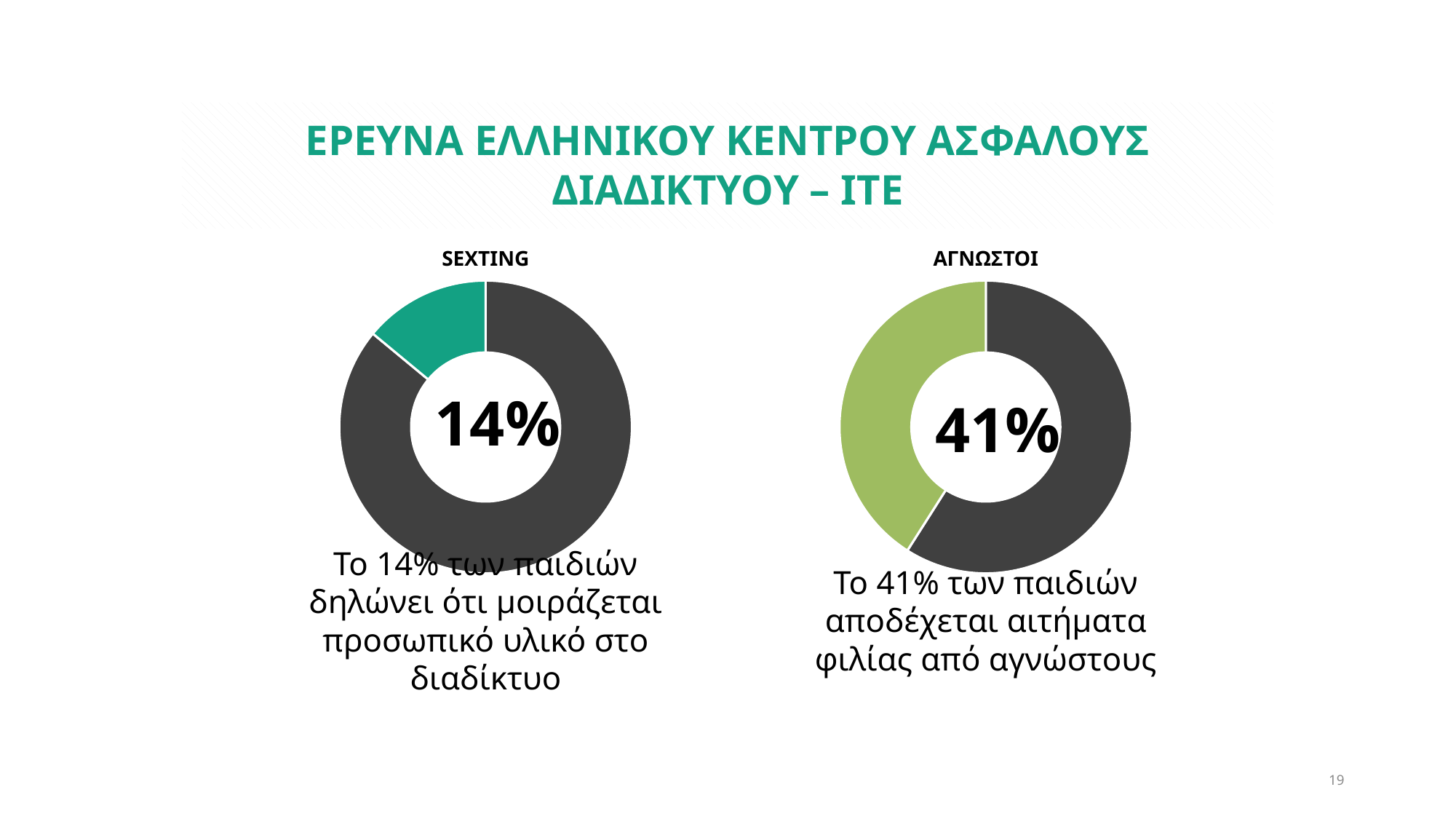
How many slices does the SEXTING donut chart have? 2 What is the difference between the percentage shown in the ΑΓΝΩΣΤΟΙ chart and the percentage shown in the SEXTING chart? 27 percentage points What kind of chart is the SEXTING chart? Donut (pie) chart How many slices does the ΑΓΝΩΣΤΟΙ donut chart have? 2 What colour is the highlighted slice in the SEXTING chart? Teal In the SEXTING chart, what percentage is shown in the centre of the donut? 14% What colour is the highlighted slice in the ΑΓΝΩΣΤΟΙ chart? Light green Which chart shows the larger highlighted percentage, SEXTING or ΑΓΝΩΣΤΟΙ? ΑΓΝΩΣΤΟΙ In the ΑΓΝΩΣΤΟΙ chart, is the highlighted (green) slice larger or smaller than the dark grey slice? Smaller What kind of chart is the ΑΓΝΩΣΤΟΙ chart? Donut (pie) chart In the SEXTING chart, is the highlighted (teal) slice larger or smaller than the dark grey slice? Smaller In the ΑΓΝΩΣΤΟΙ chart, what percentage is shown in the centre of the donut? 41%